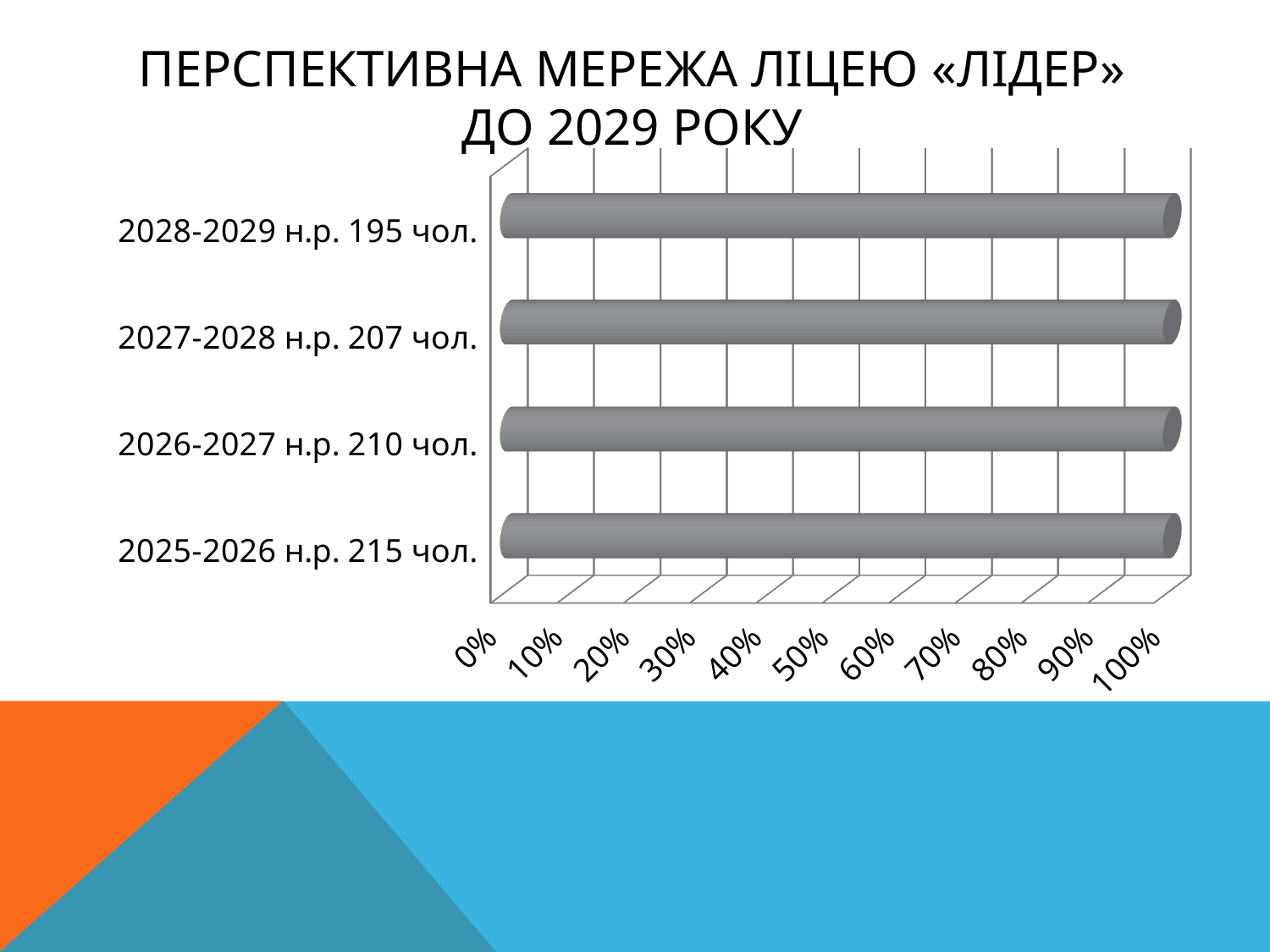
How many categories (school years) does the chart show? 4 Do the listed student numbers rise or fall from the 2025-2026 school year to the 2028-2029 school year? fall What is the highest value shown on the horizontal axis? 100% How many students are listed for the 2027-2028 school year? 207 чол. Which school year has more students listed, 2025-2026 or 2028-2029? 2025-2026 How many students are listed for the 2026-2027 school year? 210 чол. What kind of chart is shown on the slide? bar chart What is the difference between the number of students listed for 2025-2026 and for 2028-2029? 20 Is the bar for 2026-2027 н.р. greater or less than 90%? greater What is the title of the chart on the slide? ПЕРСПЕКТИВНА МЕРЕЖА ЛІЦЕЮ «ЛІДЕР» ДО 2029 РОКУ How many students are listed for the 2025-2026 school year? 215 чол. How many students are listed for the 2028-2029 school year? 195 чол.